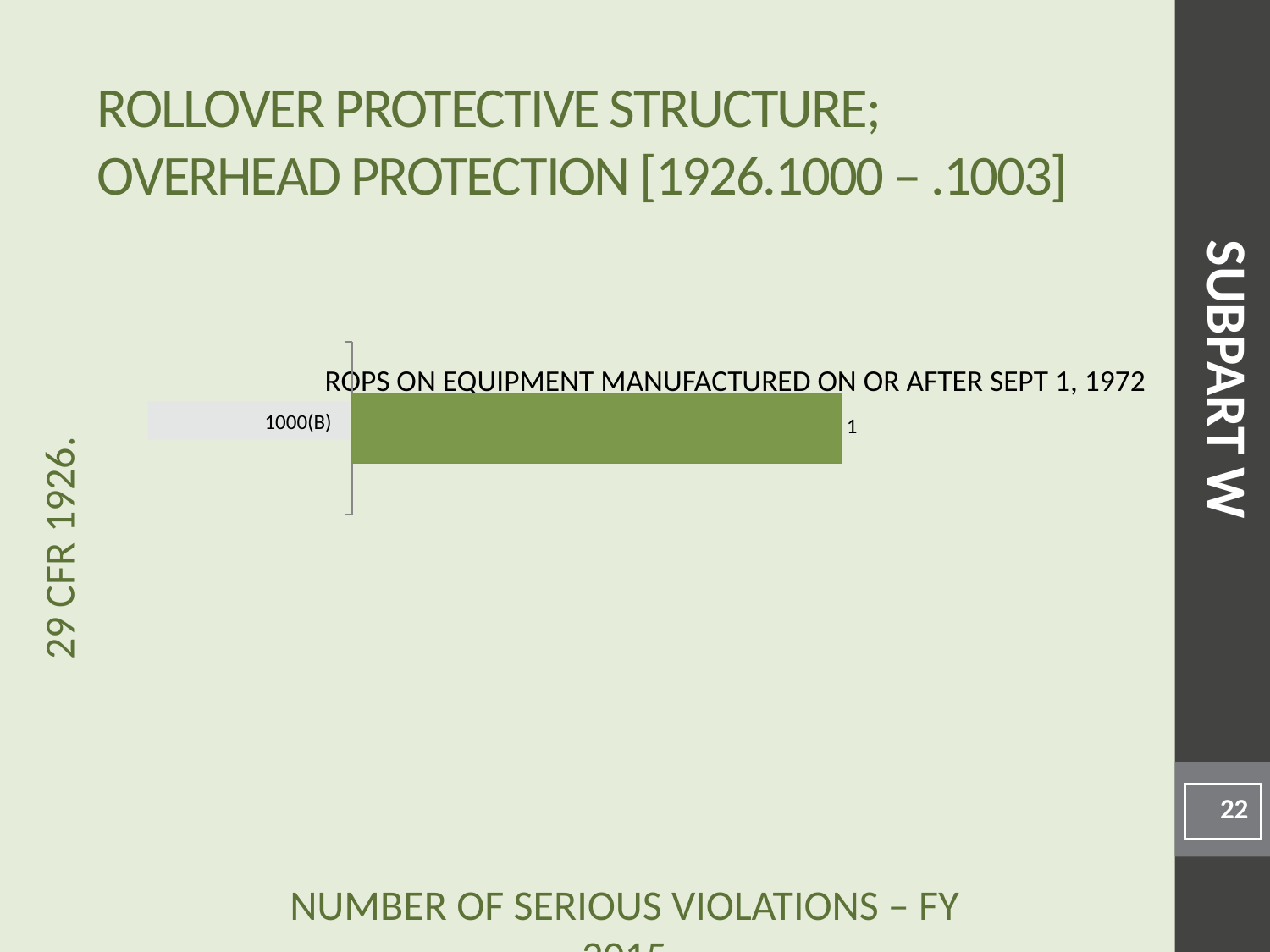
Which category is shown on the chart? 1000(B) What kind of chart is shown on the slide? bar chart Is the value for 1000(B) greater or less than 5? less What is the label printed above the bar in the chart? ROPS ON EQUIPMENT MANUFACTURED ON OR AFTER SEPT 1, 1972 What is the number of serious violations for 1000(B)? 1 How many categories does the chart show? 1